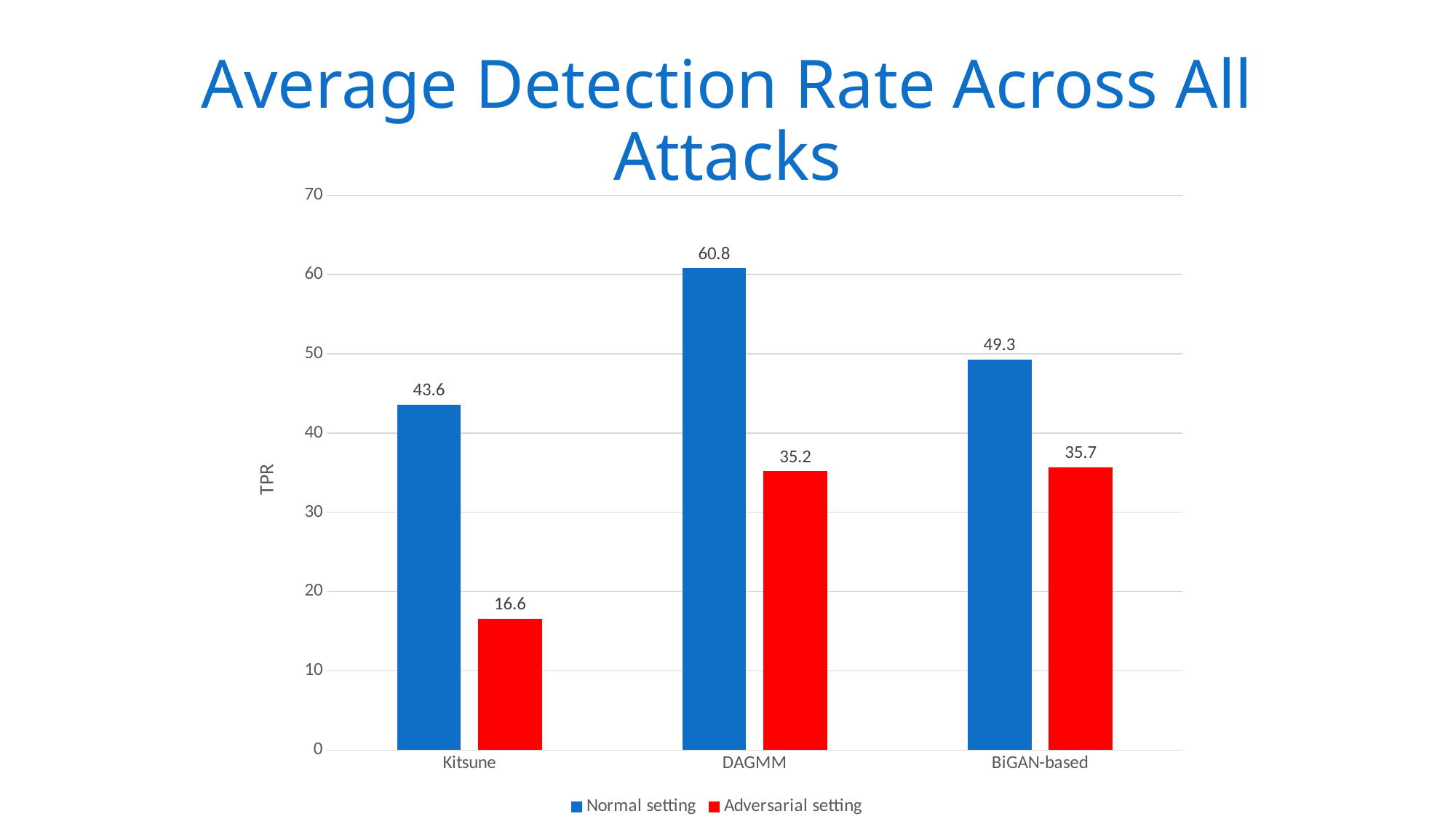
How many series does the legend list? 2 What is the label of the y axis? TPR What kind of chart is shown on the slide? Bar chart How many detectors are shown on the x axis? 3 What is the difference between the Normal setting and Adversarial setting TPR for Kitsune? 27 Which detector has the lowest TPR in the Adversarial setting? Kitsune What is the TPR for Kitsune in the Adversarial setting? 16.6 What is the difference between the Normal setting and Adversarial setting TPR for DAGMM? 25.6 What is the TPR for BiGAN-based in the Adversarial setting? 35.7 What is the TPR for DAGMM in the Normal setting? 60.8 Which detector has the highest TPR in the Normal setting? DAGMM Which is larger: the Normal setting TPR for BiGAN-based or the Normal setting TPR for Kitsune? BiGAN-based